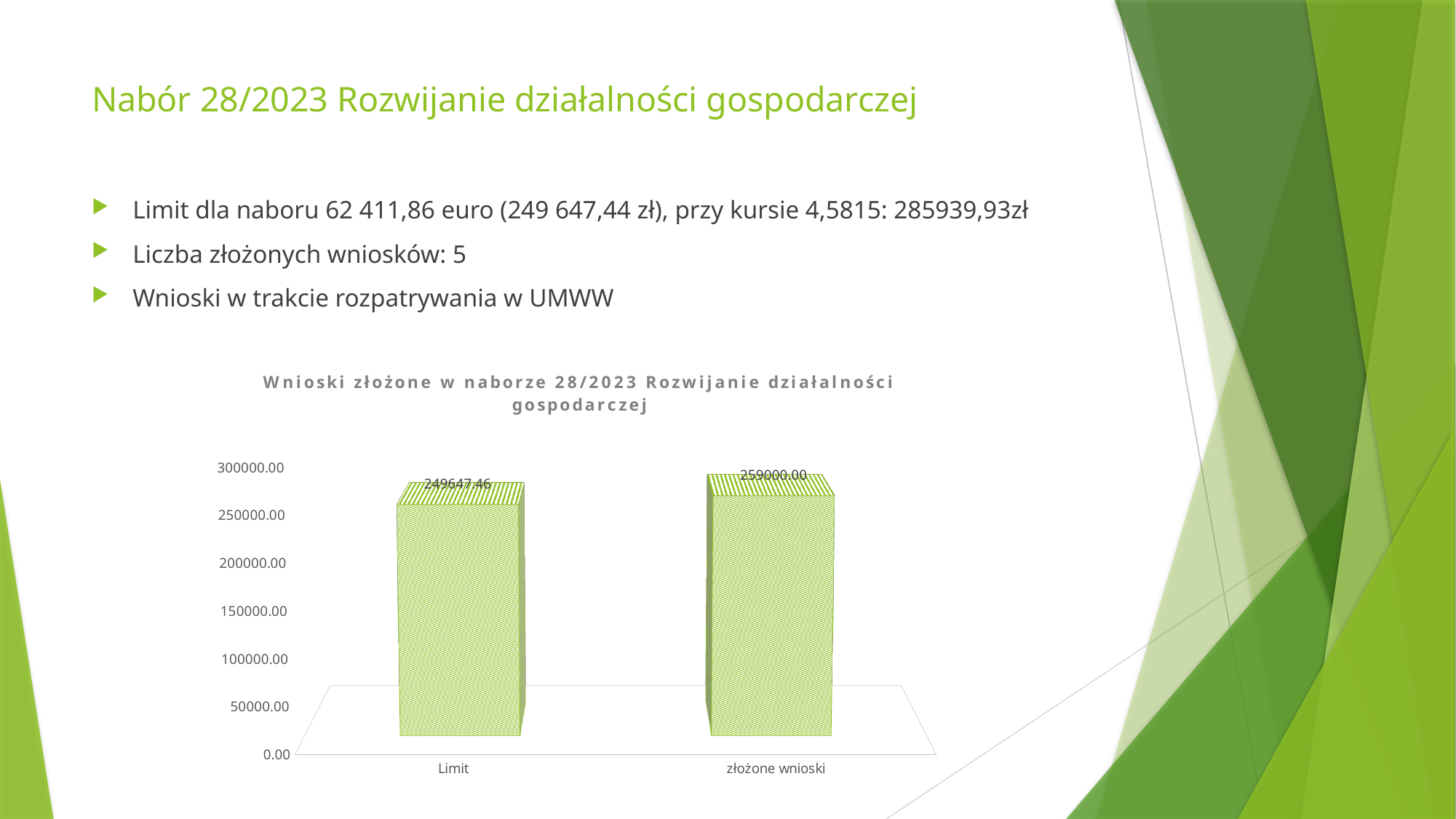
What kind of chart is shown on the slide? bar chart What is the title of the chart? Wnioski złożone w naborze 28/2023 Rozwijanie działalności gospodarczej What is the difference between the value for złożone wnioski and the value for Limit? 9352.54 How many categories are shown in the chart? 2 What is the value for złożone wnioski in the chart? 259000.00 Is the value for Limit larger or smaller than the value for złożone wnioski? smaller Is the value for złożone wnioski greater or less than 250000.00? greater What is the value for Limit in the chart? 249647.46 Is the value for Limit greater or less than 250000.00? less Which category has the higher value in the chart? złożone wnioski Which category has the lower value in the chart? Limit What is the highest value shown on the vertical axis of the chart? 300000.00